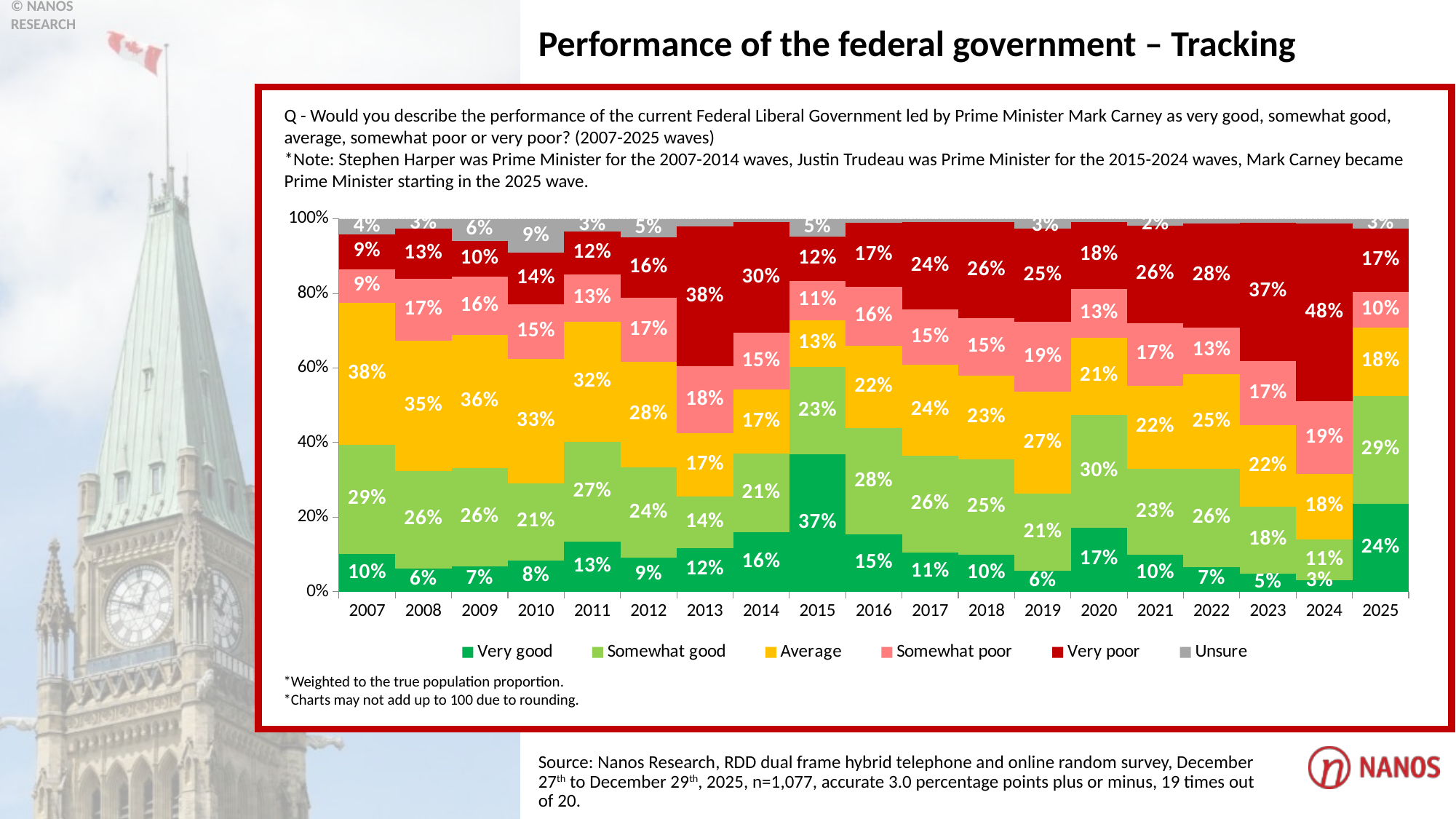
In which year was the "Very poor" share the highest? 2024 How many series does the legend list? 6 What kind of chart is shown on the slide? Stacked bar chart Did the "Very poor" share rise or fall from 2020 to 2024? Rise By how many percentage points did the "Very good" share change from 2024 to 2025? 21 percentage points What is the combined "Very good" and "Somewhat good" share in 2025? 53% Which year had a larger "Somewhat good" share, 2020 or 2024? 2020 What was the "Very poor" value in 2013? 38% How many years (waves) are shown on the x axis? 19 What percentage said "Average" in 2007? 38% In which year was the "Very good" share the lowest? 2024 What percentage of respondents rated the government's performance as "Very good" in 2025? 24%